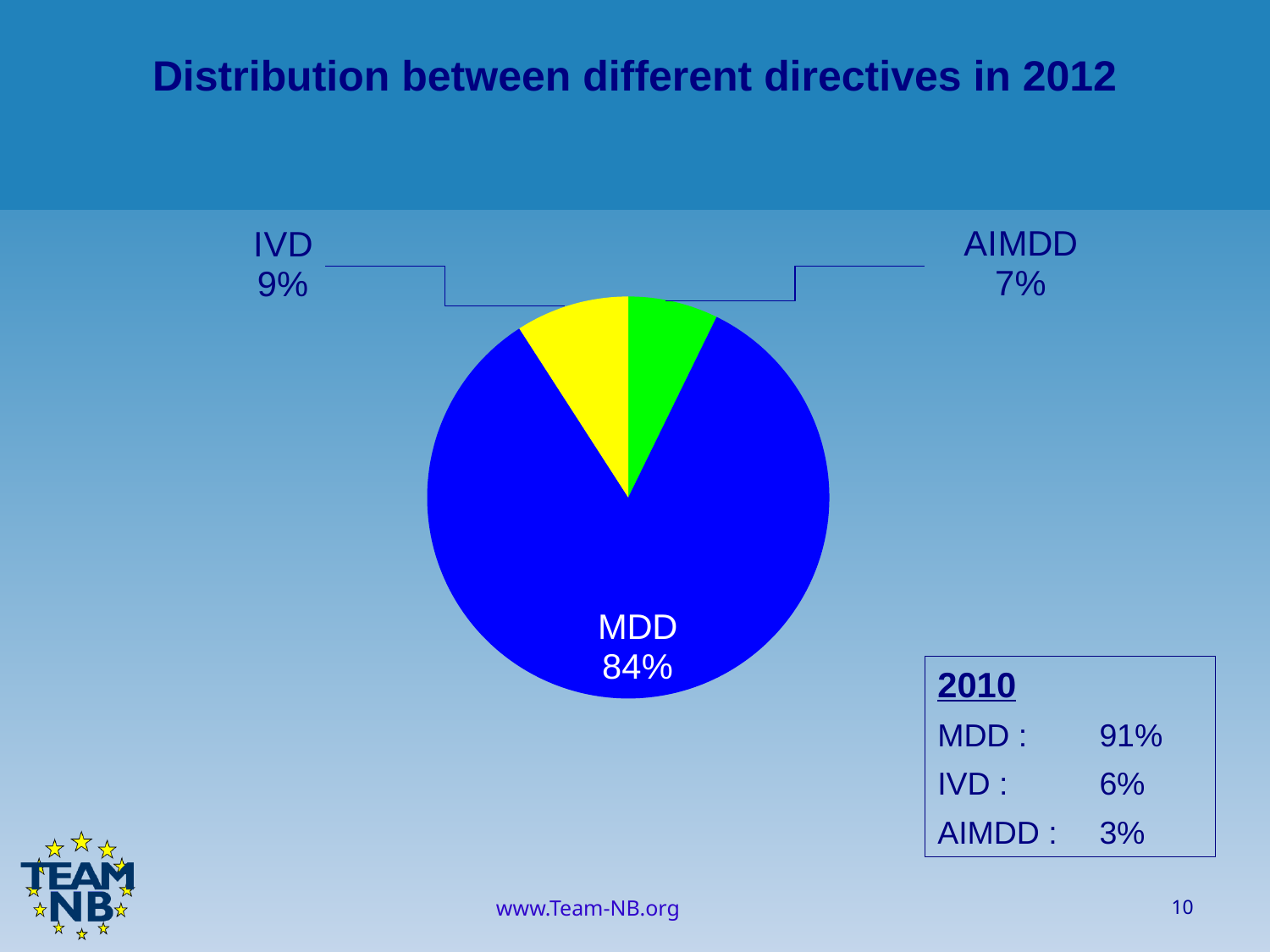
Which directive has the smallest slice of the pie? AIMDD What kind of chart is shown on the slide? pie chart What share of the pie does MDD have? 84% Which slice is larger, IVD or AIMDD? IVD What is the difference in percentage points between the IVD and AIMDD slices? 2 What is the title of the chart? Distribution between different directives in 2012 How many slices does the pie chart have? 3 Which directive has the largest slice of the pie? MDD What is the difference in percentage points between the MDD and IVD slices? 75 What share of the pie does AIMDD have? 7% What colour is the MDD slice of the pie? blue What share of the pie does IVD have? 9%